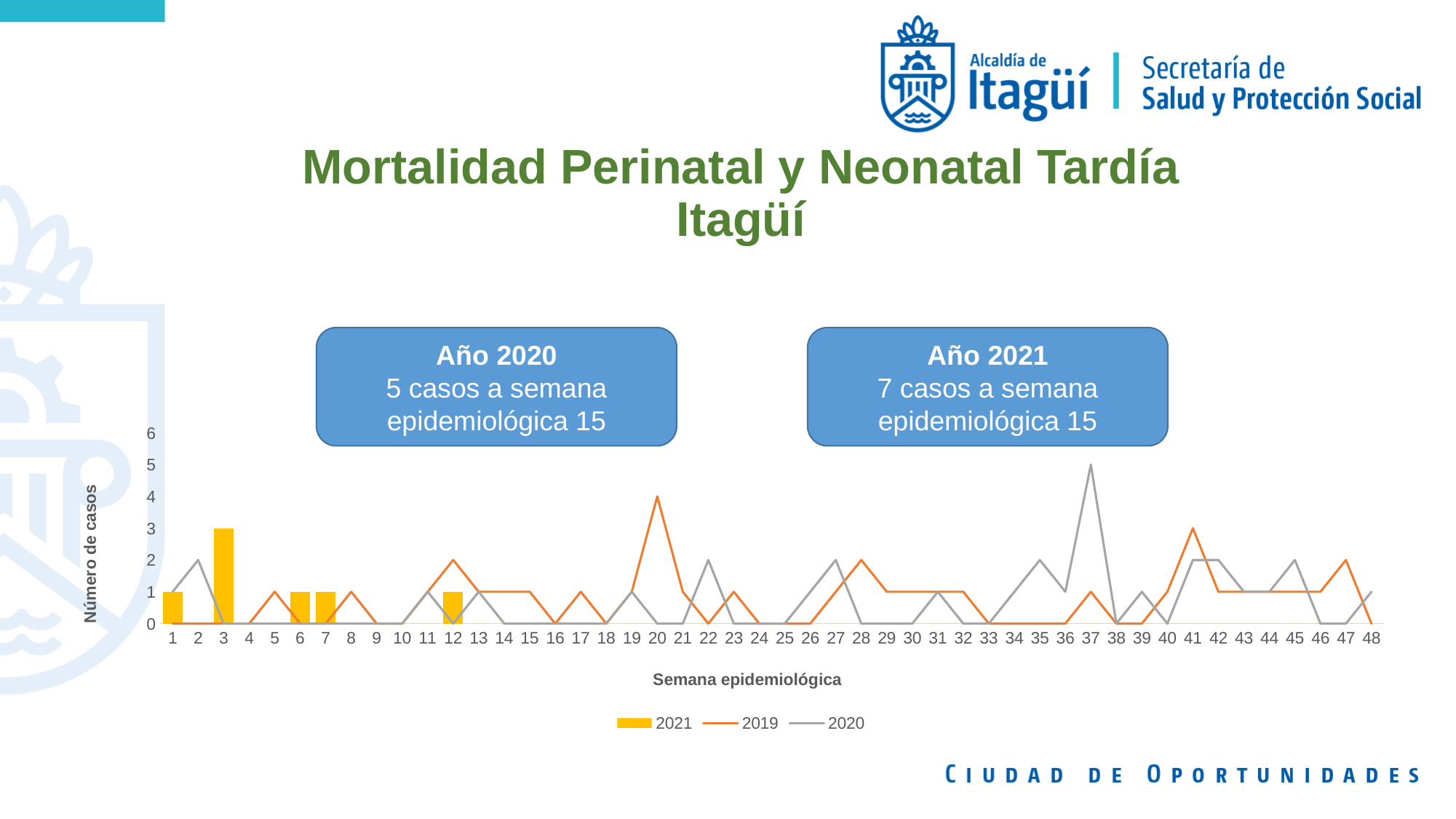
What is the value of the 2019 series in week 20? 4 Which series are listed in the legend? 2021, 2019, 2020 In which week does the 2019 series reach its highest value? Week 20 How many epidemiological weeks are shown on the x axis? 48 Which is larger: the 2020 value in week 37 or the 2019 value in week 20? 2020 value in week 37 What is the value of the 2021 series in week 3? 3 What is the value of the 2020 series in week 37? 5 How many series does the legend list? 3 What is the difference between the 2020 peak in week 37 and the 2019 peak in week 20? 1 What kind of chart is shown on the slide? Combined bar and line chart In which week does the 2020 series reach its highest value? Week 37 In which week does the 2021 series reach its highest value? Week 3